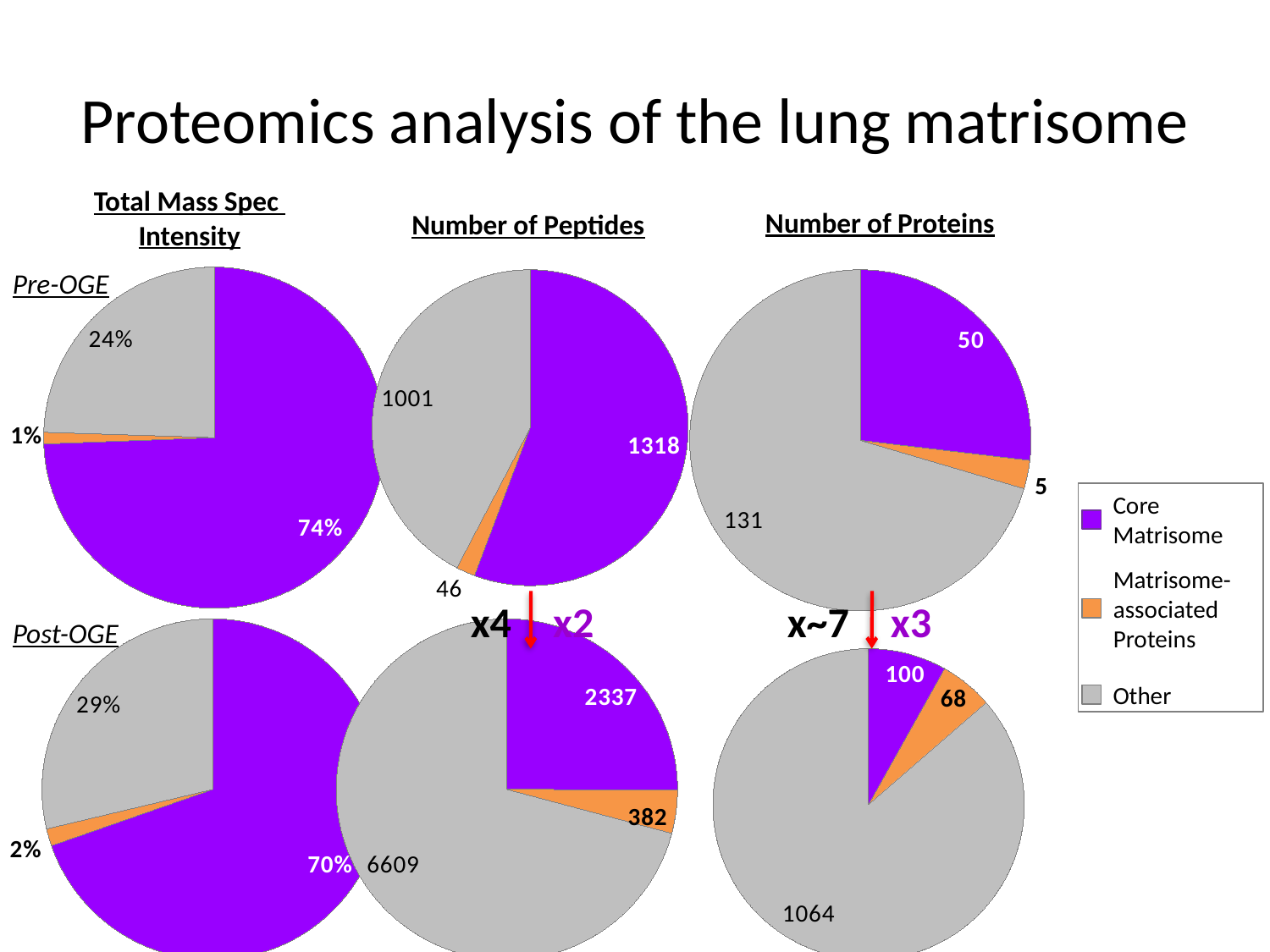
In the Pre-OGE Number of Peptides pie chart, which category has the smallest slice? Matrisome-associated Proteins In the Post-OGE Number of Proteins pie chart, which category has the largest slice? Other In the Pre-OGE Number of Proteins pie chart, what is the value for Matrisome-associated Proteins? 5 How many categories does the legend list? 3 In the Post-OGE Number of Peptides pie chart, what is the value for Core Matrisome? 2337 In the Pre-OGE Number of Proteins pie chart, which is larger, Core Matrisome or Other? Other How many pie charts are shown on the slide? 6 In the Post-OGE Number of Proteins pie chart, what is the difference between Other and Core Matrisome? 964 In the Pre-OGE Number of Peptides pie chart, what is the value for Other? 1001 In the Post-OGE Total Mass Spec Intensity pie chart, what percentage is Other? 29% In the Pre-OGE Total Mass Spec Intensity pie chart, what percentage is Core Matrisome? 74% What type of chart is used for the Number of Peptides data? Pie chart